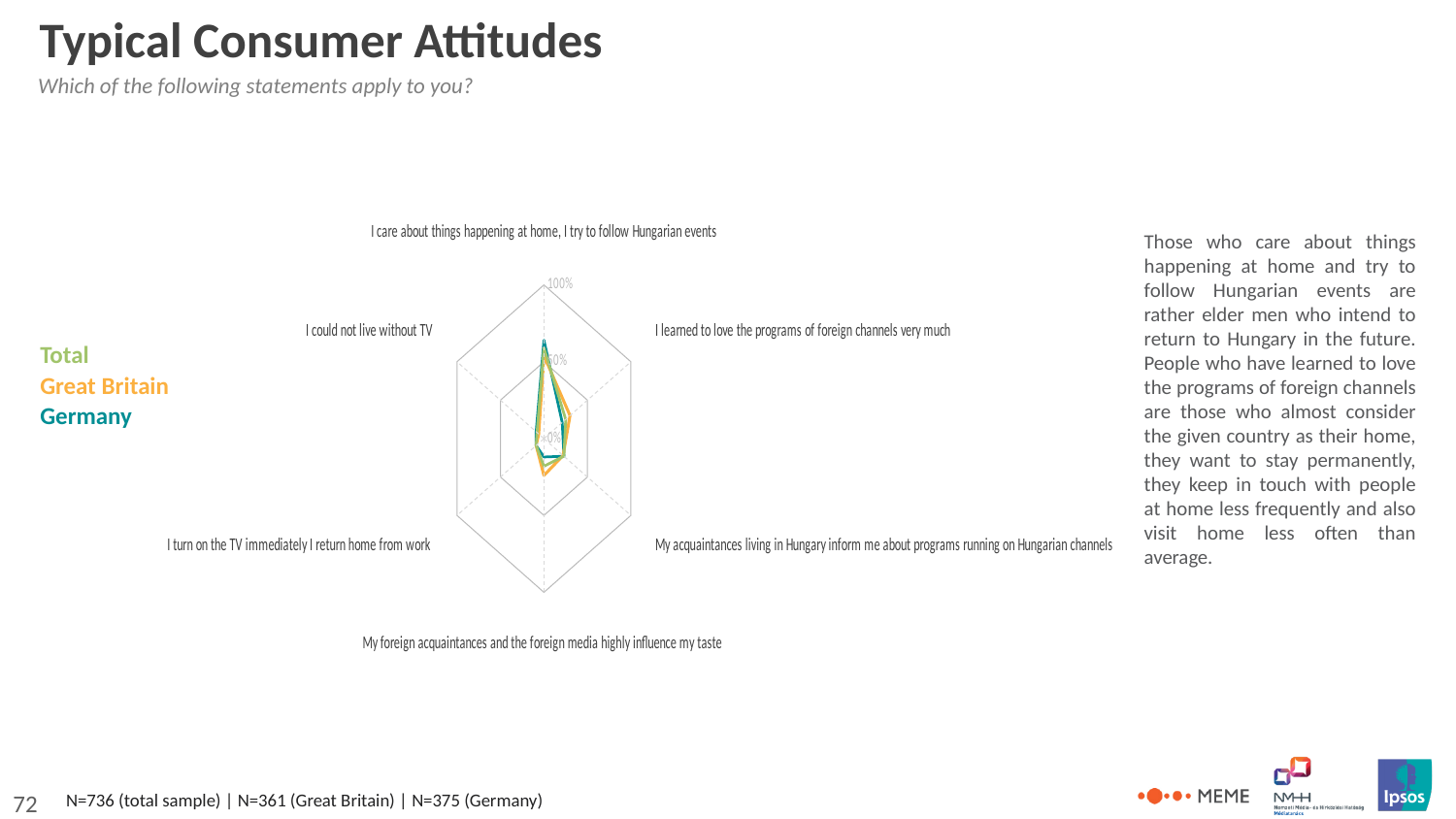
How many series does the legend list for the radar chart? 3 Which statement has the highest values on the radar chart? I care about things happening at home, I try to follow Hungarian events Is the value for 'I could not live without TV' greater or less than 50%? less Is the value for 'I turn on the TV immediately I return home from work' greater or less than 50%? less Which series are listed in the legend of the radar chart? Total, Great Britain, Germany What kind of chart is shown on the slide? Radar chart Which is larger: the value for 'I care about things happening at home, I try to follow Hungarian events' or the value for 'I could not live without TV'? I care about things happening at home, I try to follow Hungarian events What is the highest percentage tick shown on the radar chart's axis? 100% Is the value for 'I learned to love the programs of foreign channels very much' greater or less than 50%? less How many statements (categories) are plotted on the radar chart? 6